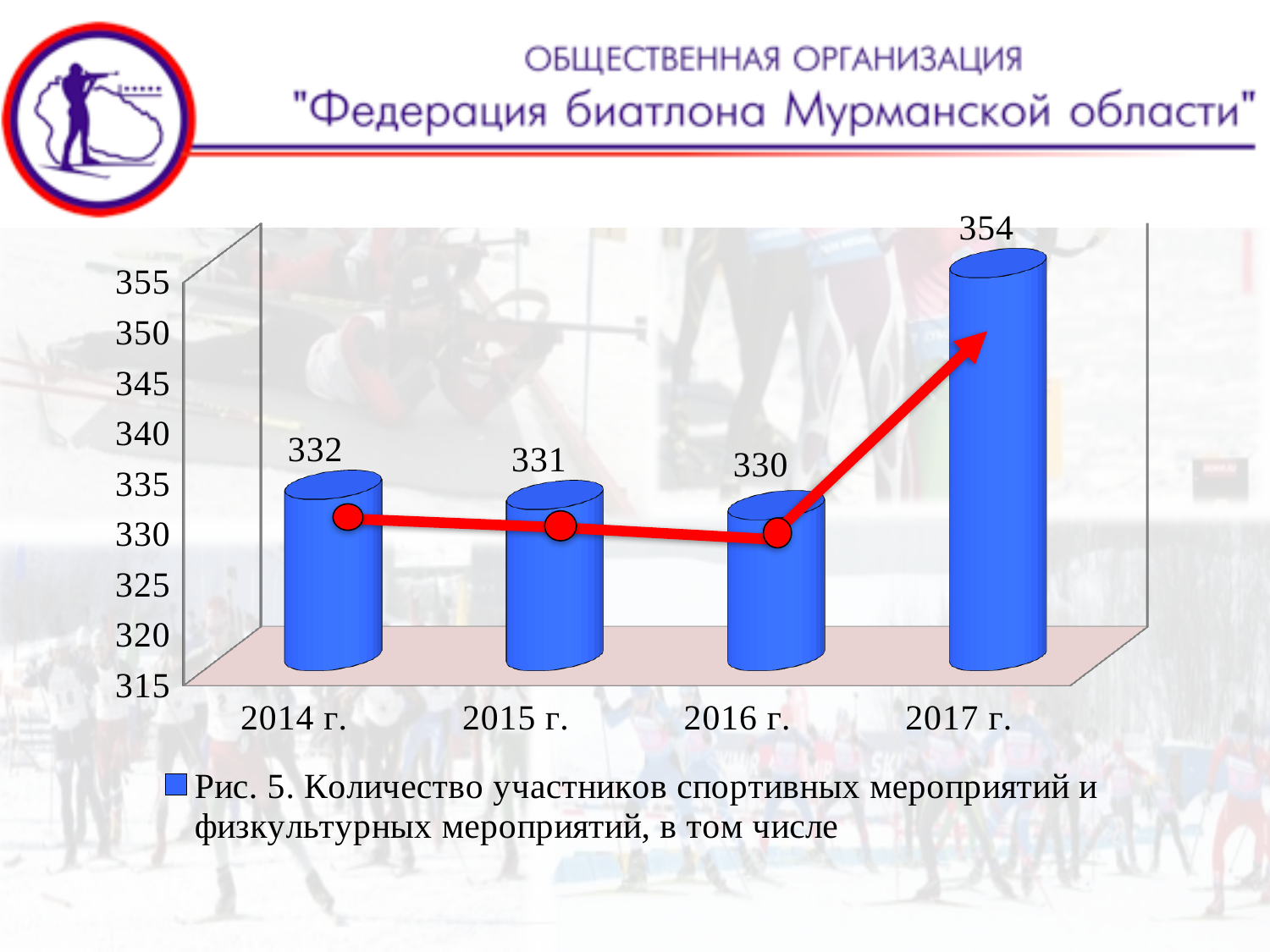
How many years are shown on the x axis? 4 Which is larger, the value for 2014 г. or the value for 2017 г.? 2017 г. What kind of chart is this? bar chart Which year has the highest value? 2017 г. What is the value for 2016 г.? 330 What is the value for 2014 г.? 332 Which year has the lowest value? 2016 г. What is the value for 2017 г.? 354 What is the difference between the values for 2014 г. and 2015 г.? 1 What is the difference between the values for 2017 г. and 2016 г.? 24 How many series does the legend list? 1 Is the value for 2017 г. greater or less than 350? greater